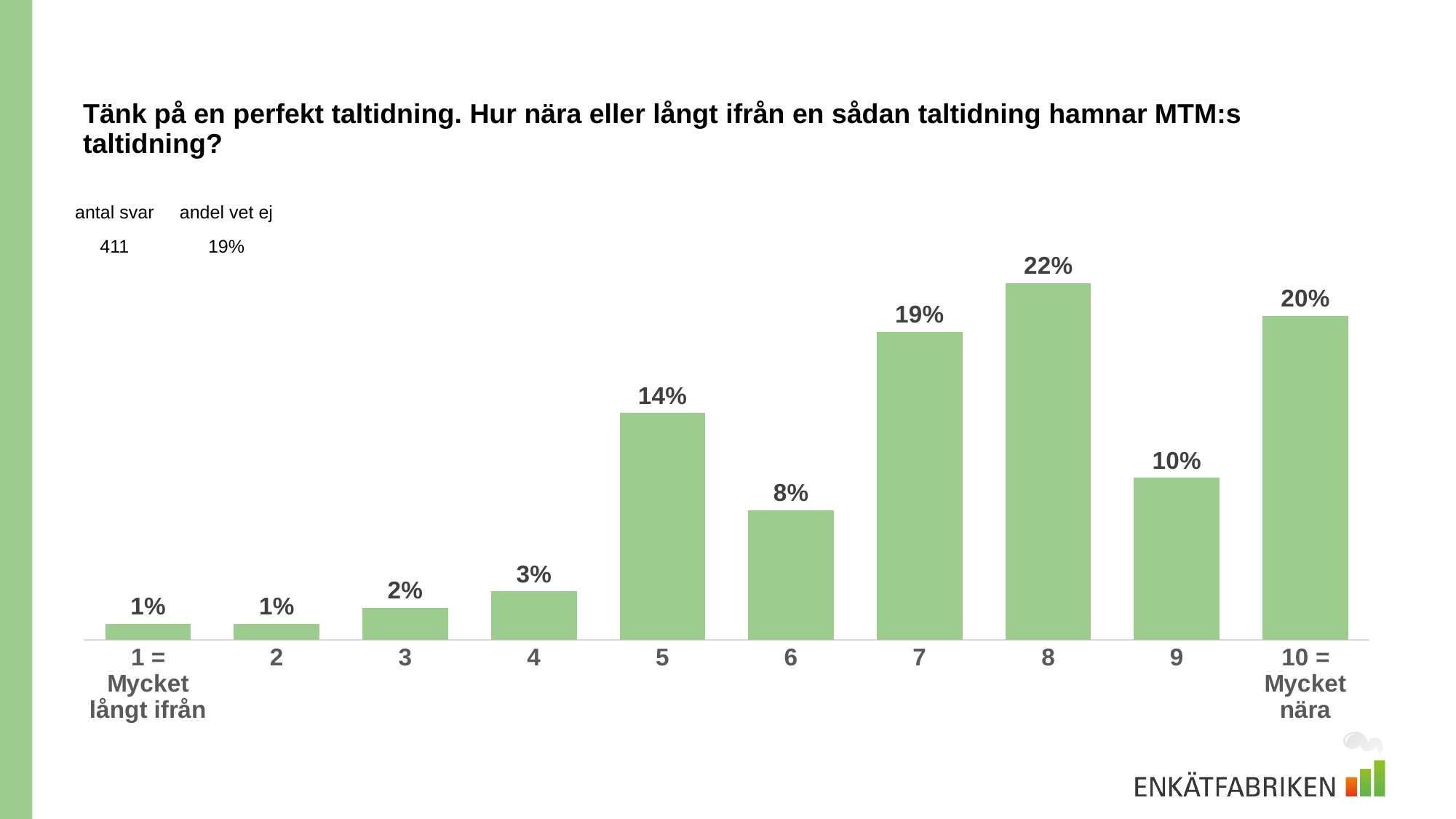
What is the number of responses (antal svar) shown on the slide? 411 What is the difference between the values for rating 8 and rating 9? 12% Which is larger, the value for rating 7 or the value for rating 6? Rating 7 What percentage of respondents gave a rating of 5? 14% What kind of chart is shown on the slide? Bar chart What is the share of 'vet ej' (don't know) answers shown on the slide? 19% What percentage of respondents gave a rating of 8? 22% What is the value for the category '10 = Mycket nära'? 20% How many rating categories are shown on the x axis? 10 What is the value for rating 6? 8% What is the total of the values for ratings 1, 2, 3 and 4? 7% Which rating category has the highest value? 8